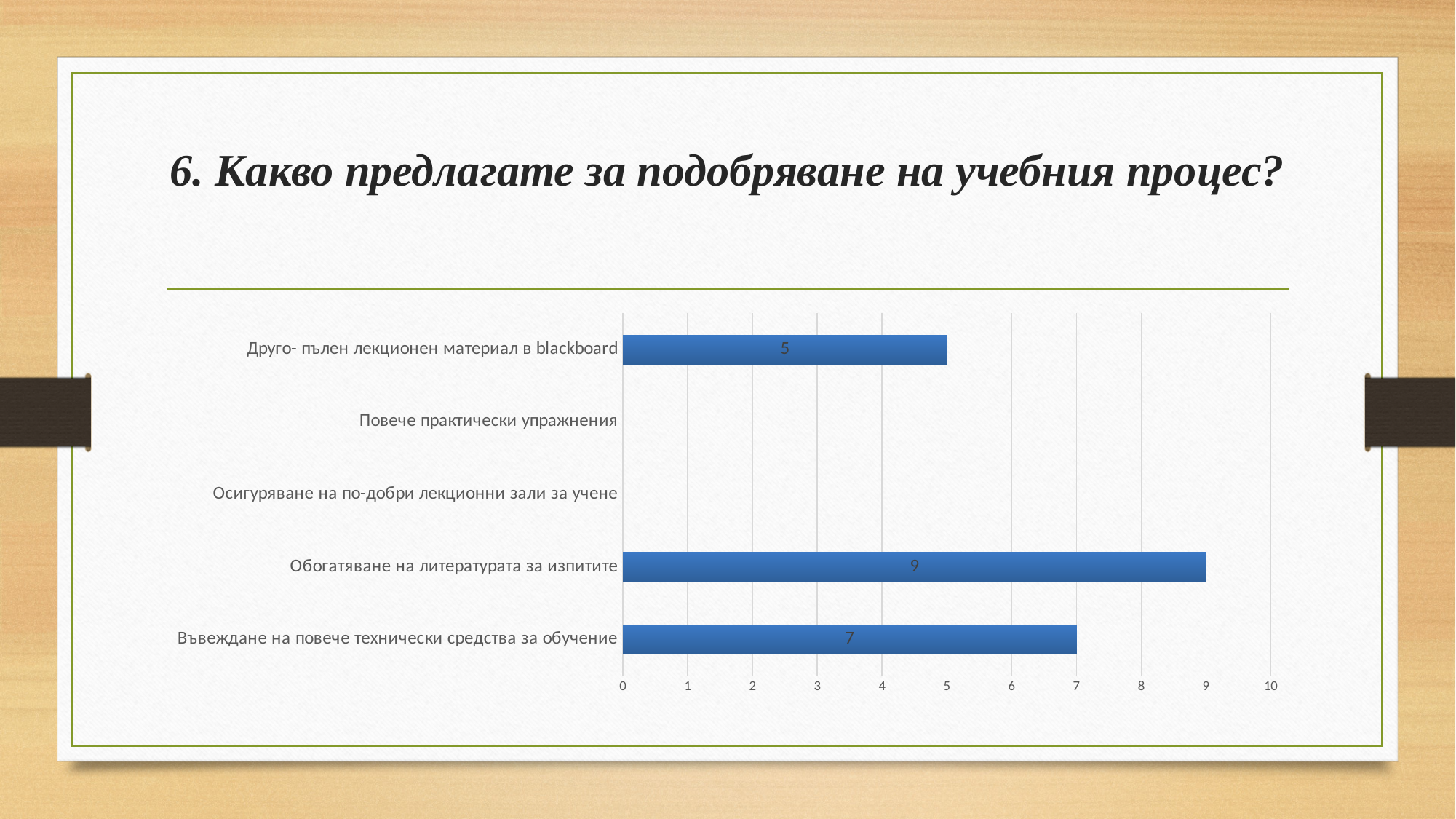
What kind of chart is shown on the slide? Bar chart What is the value for "Друго- пълен лекционен материал в blackboard"? 5 What is the title of the slide containing the chart? 6. Какво предлагате за подобряване на учебния процес? What is the difference between the values for "Обогатяване на литературата за изпитите" and "Въвеждане на повече технически средства за обучение"? 2 What is the difference between the values for "Обогатяване на литературата за изпитите" and "Друго- пълен лекционен материал в blackboard"? 4 Which is larger: the value for "Въвеждане на повече технически средства за обучение" or the value for "Друго- пълен лекционен материал в blackboard"? Въвеждане на повече технически средства за обучение How many categories are listed on the chart's vertical axis? 5 Which category has the highest value? Обогатяване на литературата за изпитите Is the value for "Друго- пълен лекционен материал в blackboard" greater or less than 6? less Is the value for "Обогатяване на литературата за изпитите" greater or less than 8? greater What is the value for "Обогатяване на литературата за изпитите"? 9 What is the value for "Въвеждане на повече технически средства за обучение"? 7